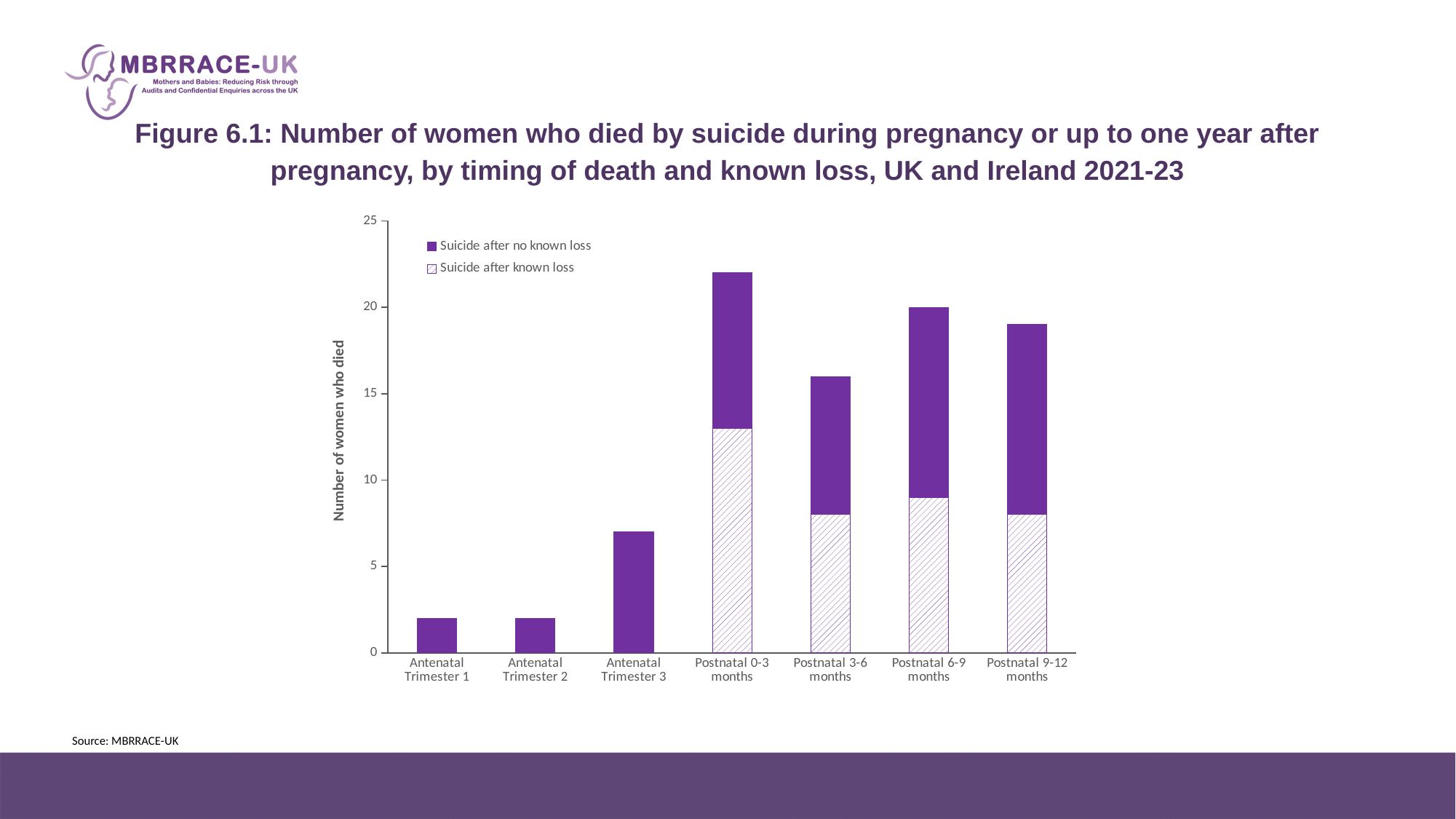
Is the value for Antenatal Trimester 3 greater or less than 5? greater What is the label of the y axis? Number of women who died Is the value for Antenatal Trimester 1 greater or less than 5? less What kind of chart is shown on the slide? Bar chart How many timing-of-death categories are shown on the x axis? 7 Which timing-of-death category has the highest total number of women who died? Postnatal 0-3 months Do the totals rise or fall from Antenatal Trimester 1 to Postnatal 0-3 months? Rise Which has a larger total: Postnatal 0-3 months or Postnatal 3-6 months? Postnatal 0-3 months What is the total number of women who died for Postnatal 6-9 months? 20 How many series does the legend list? 2 Is the 'Suicide after known loss' value for Postnatal 0-3 months greater or less than 10? greater